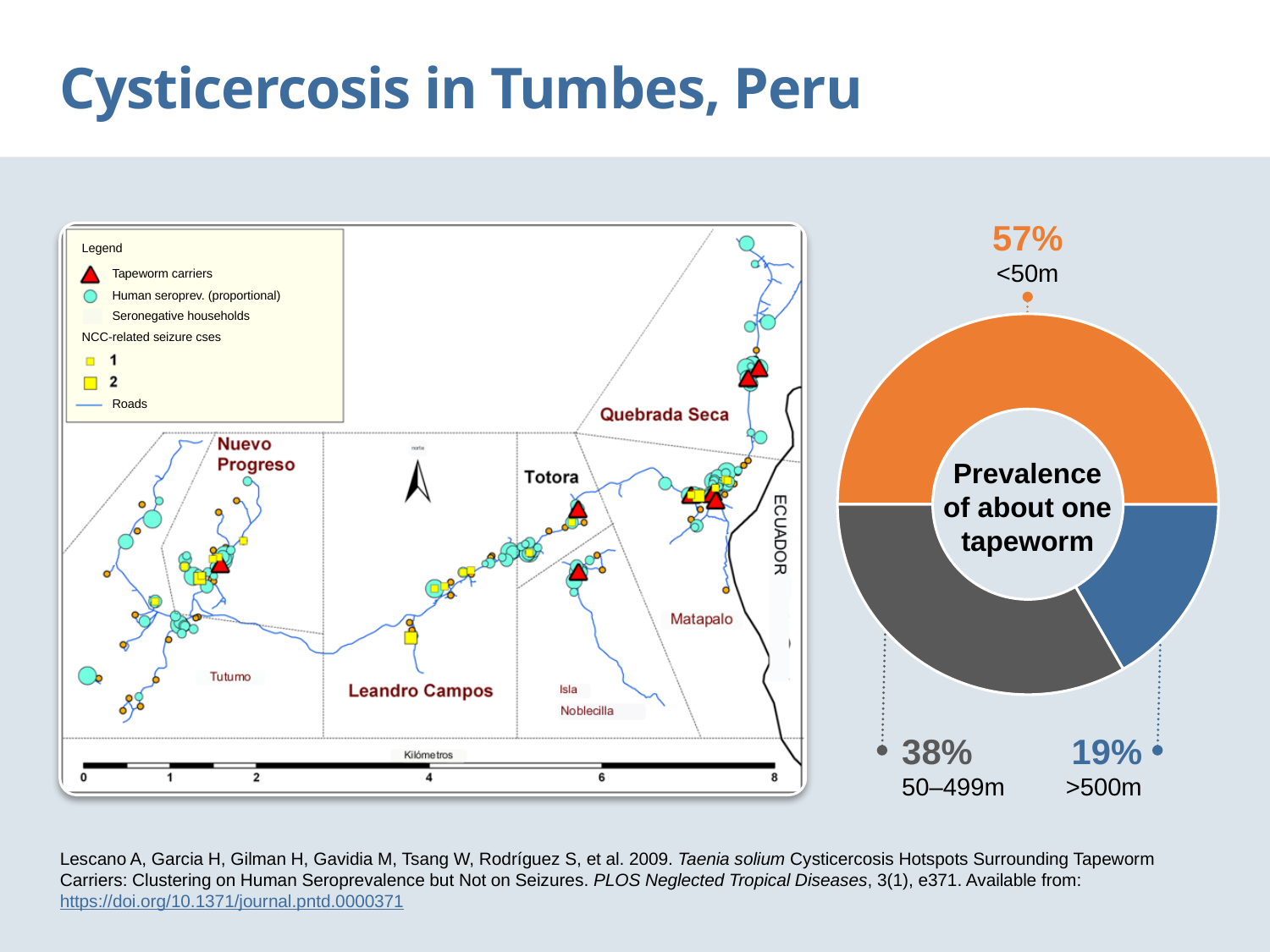
On the donut chart, what is the difference between the values for <50m and >500m? 38% On the donut chart, which distance category has the highest value? <50m How many distance categories are shown on the donut chart? 3 What kind of chart is shown on the right side of the slide? Donut (pie) chart On the donut chart, what is the value shown for the >500m category? 19% On the donut chart, what colour is the segment for the <50m category? Orange On the donut chart, what is the difference between the values for <50m and 50–499m? 19% On the donut chart, which distance category has the lowest value? >500m On the donut chart, which is larger, the value for 50–499m or the value for >500m? 50–499m What text is written in the centre of the donut chart? Prevalence of about one tapeworm On the donut chart, what is the value shown for the <50m category? 57% On the donut chart, what is the value shown for the 50–499m category? 38%